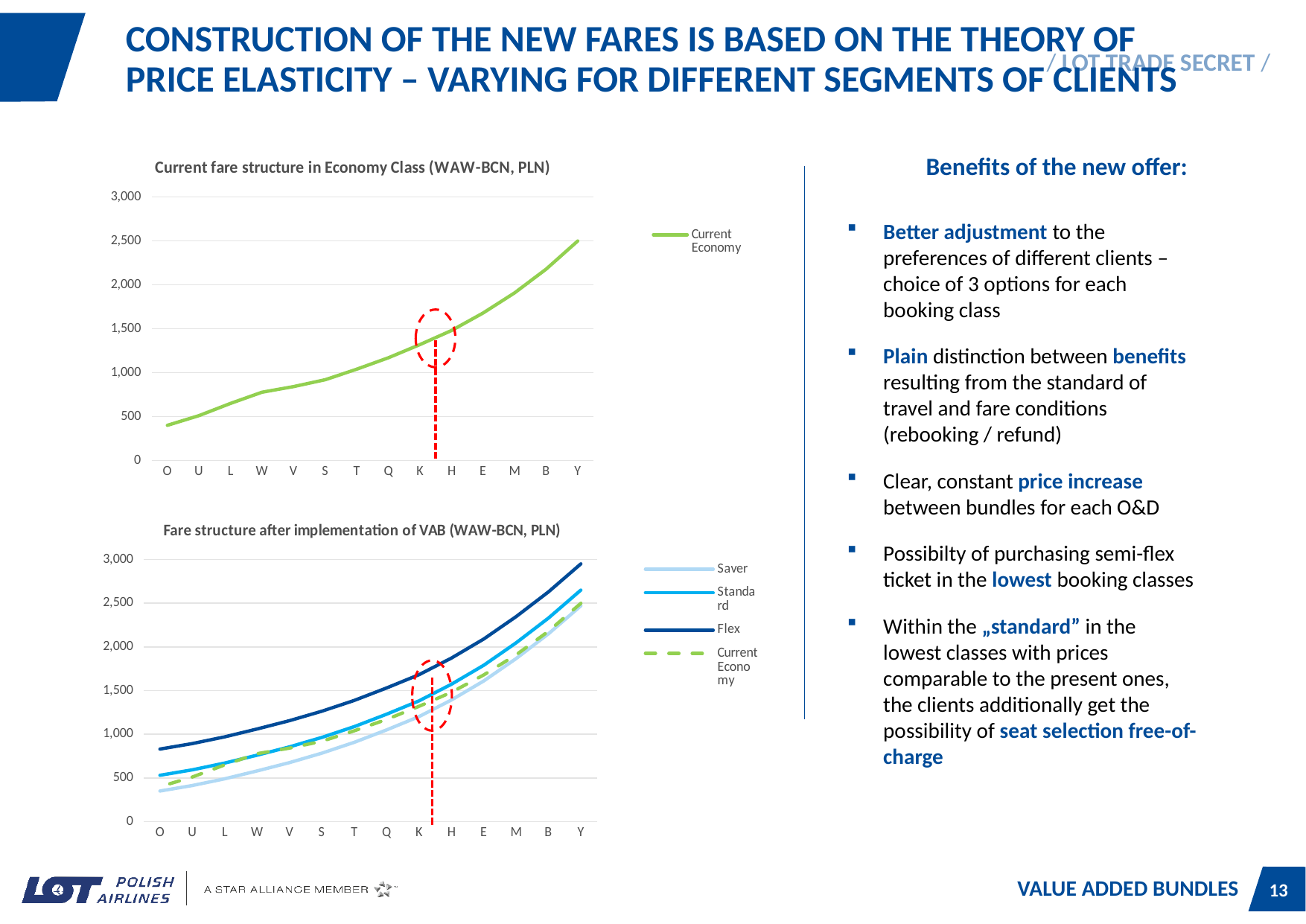
In the bottom chart 'Fare structure after implementation of VAB', is the Flex value for O greater or less than 1,000? less In the top chart 'Current fare structure in Economy Class', is the value for Y greater or less than 2,000? greater What kind of chart is the top chart titled 'Current fare structure in Economy Class (WAW-BCN, PLN)'? line chart In the top chart 'Current fare structure in Economy Class', is the value for K greater or less than 1,000? greater In the top chart 'Current fare structure in Economy Class', how many booking classes are shown on the x axis? 14 In the top chart 'Current fare structure in Economy Class', do the values rise or fall from O to Y? rise In the bottom chart 'Fare structure after implementation of VAB', which series has the highest value at Y? Flex In the bottom chart 'Fare structure after implementation of VAB', which series has the lowest value at O? Saver Which series in the bottom chart 'Fare structure after implementation of VAB' is drawn with a dashed line? Current Economy How many series does the legend of the bottom chart 'Fare structure after implementation of VAB' list? 4 In the bottom chart 'Fare structure after implementation of VAB', which is larger at K: Flex or Saver? Flex